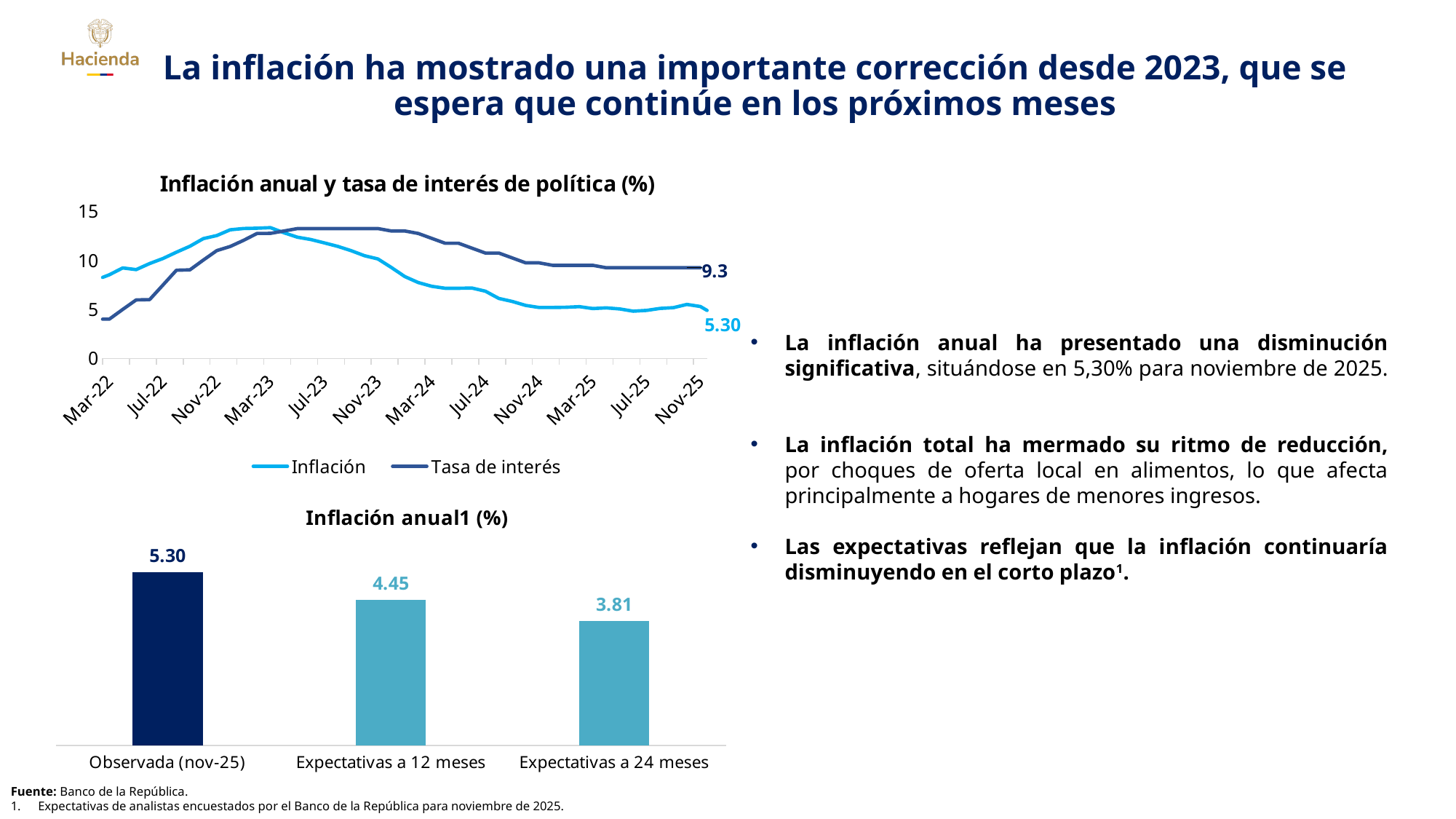
In the chart titled 'Inflación anual1 (%)', what is the difference between Observada (nov-25) and Expectativas a 24 meses? 1.49 In the chart titled 'Inflación anual1 (%)', how many bars are shown? 3 In the chart titled 'Inflación anual y tasa de interés de política (%)', is the Inflación value at Nov-25 greater or less than 10? less In the chart titled 'Inflación anual1 (%)', which category has the highest value? Observada (nov-25) In the chart titled 'Inflación anual y tasa de interés de política (%)', how many series does the legend list? 2 In the chart titled 'Inflación anual1 (%)', what is the value for Expectativas a 12 meses? 4.45 In the chart titled 'Inflación anual y tasa de interés de política (%)', what is the final value shown for Tasa de interés? 9.3 In the chart titled 'Inflación anual1 (%)', what is the value for Expectativas a 24 meses? 3.81 In the chart titled 'Inflación anual y tasa de interés de política (%)', what is the final value shown for Inflación? 5.30 In the chart titled 'Inflación anual y tasa de interés de política (%)', does the Inflación line rise or fall between Mar-23 and Nov-25? fall In the chart titled 'Inflación anual y tasa de interés de política (%)', which series ends higher at Nov-25, Inflación or Tasa de interés? Tasa de interés What kind of chart is 'Inflación anual y tasa de interés de política (%)'? line chart